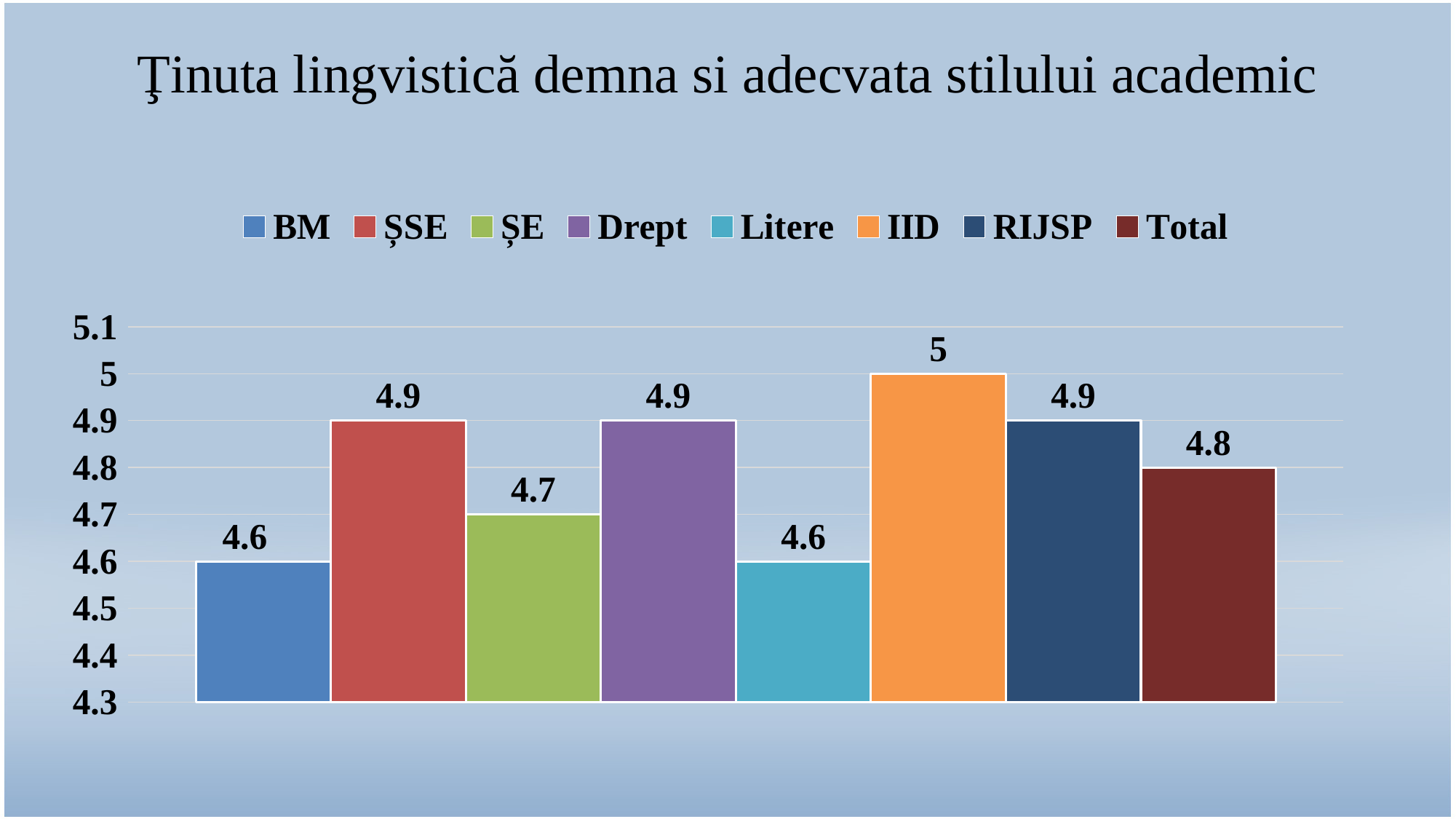
How many bars are plotted in the chart? 8 What is the value for Litere? 4.6 Which is larger, the value for Drept or the value for Total? Drept What is the difference between the values for ȘSE and ȘE? 0.2 What kind of chart is shown on the slide? bar chart Which category has the highest value? IID How many entries does the legend list? 8 Is the value for RIJSP greater or less than 4.8? greater What is the value for ȘE? 4.7 What is the value for Total? 4.8 What is the value for IID? 5 What is the difference between the values for IID and BM? 0.4